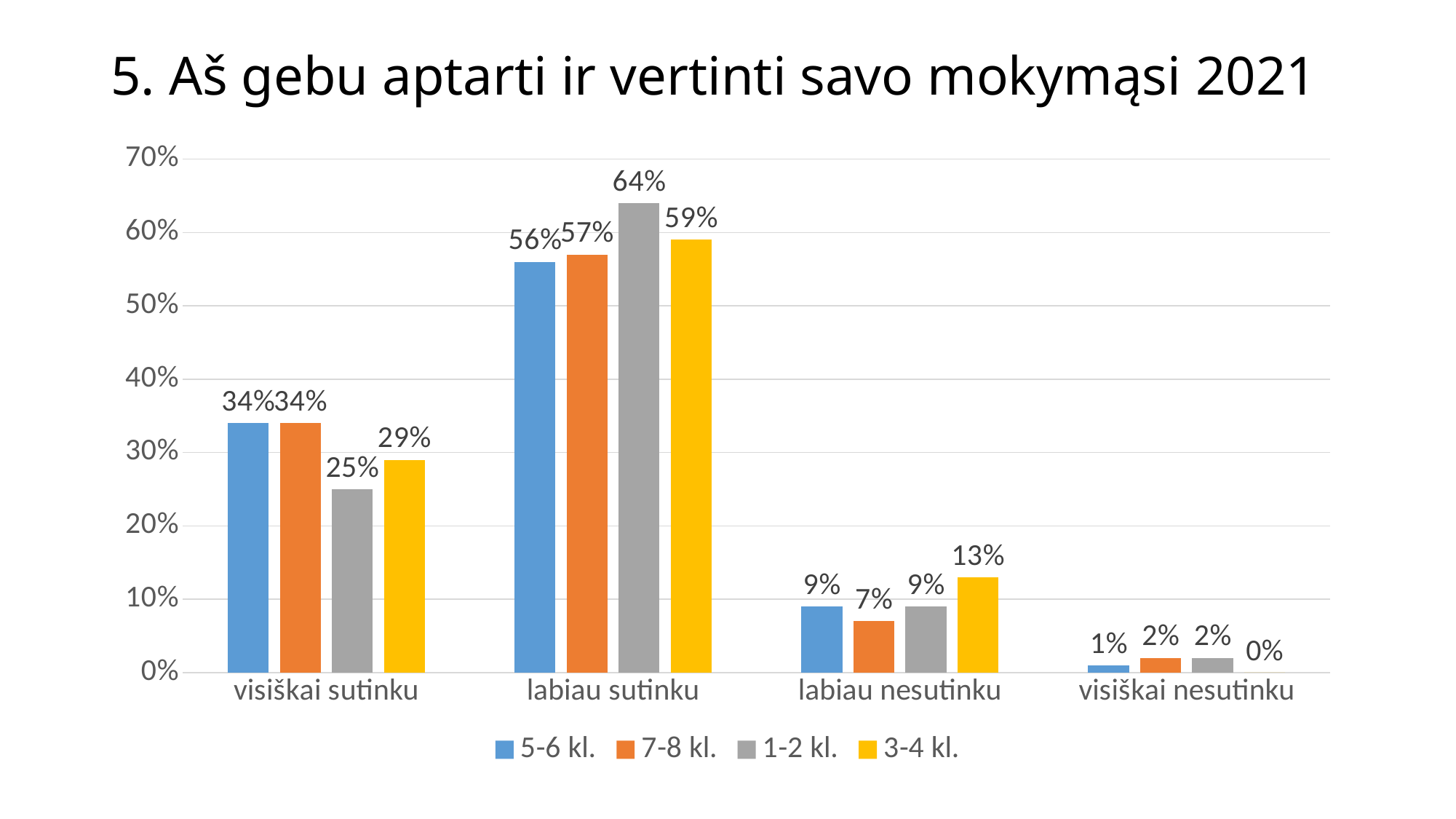
Is the value for 3-4 kl. in the 'labiau sutinku' category greater or less than 50%? greater How many series does the legend list? 4 Which series has the lowest value in the 'visiškai nesutinku' category? 3-4 kl. How many categories are shown on the x axis? 4 Which is larger in the 'labiau nesutinku' category: 3-4 kl. or 5-6 kl.? 3-4 kl. What kind of chart is shown on the slide? bar chart What is the difference between the 1-2 kl. and 5-6 kl. values in the 'labiau sutinku' category? 8% Which series has the highest value in the 'labiau sutinku' category? 1-2 kl. What is the value for 7-8 kl. in the 'labiau nesutinku' category? 7% What is the value for 3-4 kl. in the 'visiškai sutinku' category? 29% What is the value for 1-2 kl. in the 'labiau sutinku' category? 64% What is the title of the chart? 5. Aš gebu aptarti ir vertinti savo mokymąsi 2021